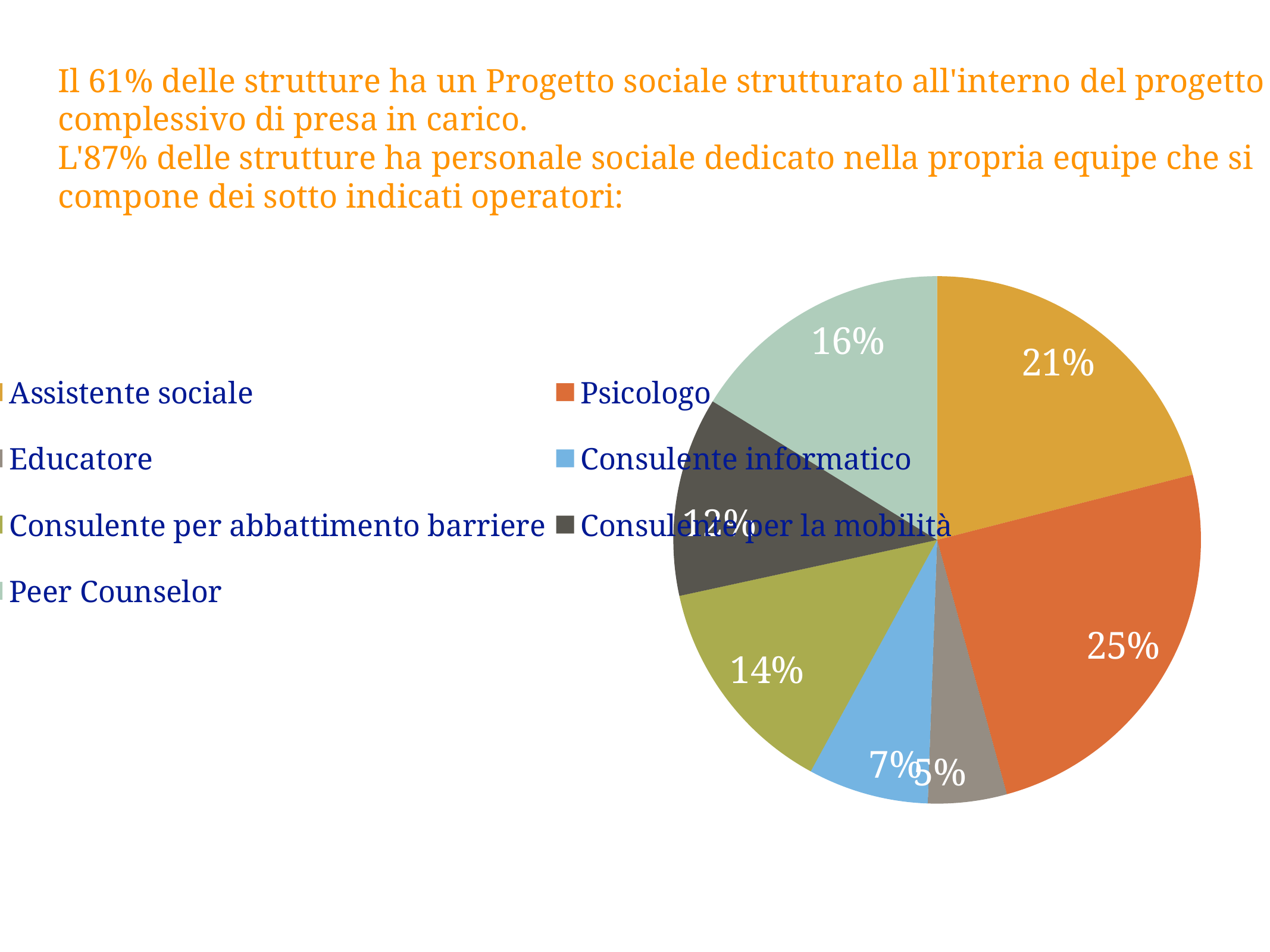
What share of the pie does Educatore have? 5% What kind of chart is shown on the slide? pie chart What share of the pie does Peer Counselor have? 16% What share of the pie does Assistente sociale have? 21% What share of the pie does Psicologo have? 25% How many categories does the pie chart show? 7 How many percentage points larger is the Psicologo slice than the Assistente sociale slice? 4 What share of the pie does Consulente per abbattimento barriere have? 14% What share of the pie does Consulente informatico have? 7% Which category has the largest slice of the pie? Psicologo Which slice is larger, Peer Counselor or Consulente per abbattimento barriere? Peer Counselor Which category has the smallest slice of the pie? Educatore